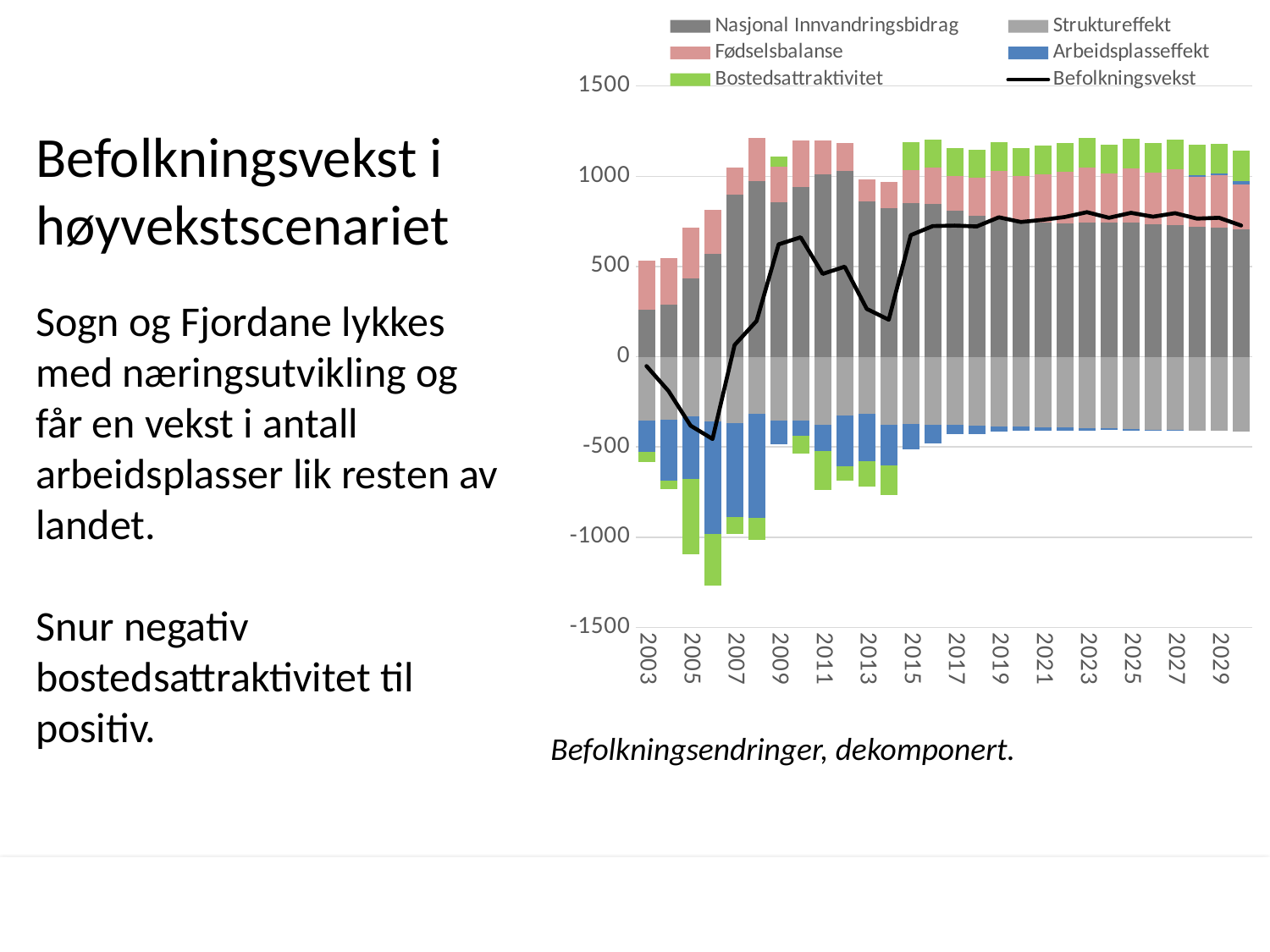
In which year does the Befolkningsvekst line reach its lowest point? 2006 Is the Befolkningsvekst value for 2014 greater or less than 500? less Is the Befolkningsvekst value for 2003 greater or less than 0? less Which series is drawn as a black line in the chart? Befolkningsvekst Does the Befolkningsvekst line rise or fall between 2003 and 2006? fall Is the Befolkningsvekst value for 2009 greater or less than 500? greater How many series does the chart legend list? 6 What kind of chart is shown on the slide? Stacked bar chart with a line What is the caption printed below the chart? Befolkningsendringer, dekomponert. Which year has the higher Befolkningsvekst value, 2009 or 2014? 2009 Does the Befolkningsvekst line rise or fall between 2006 and 2009? rise